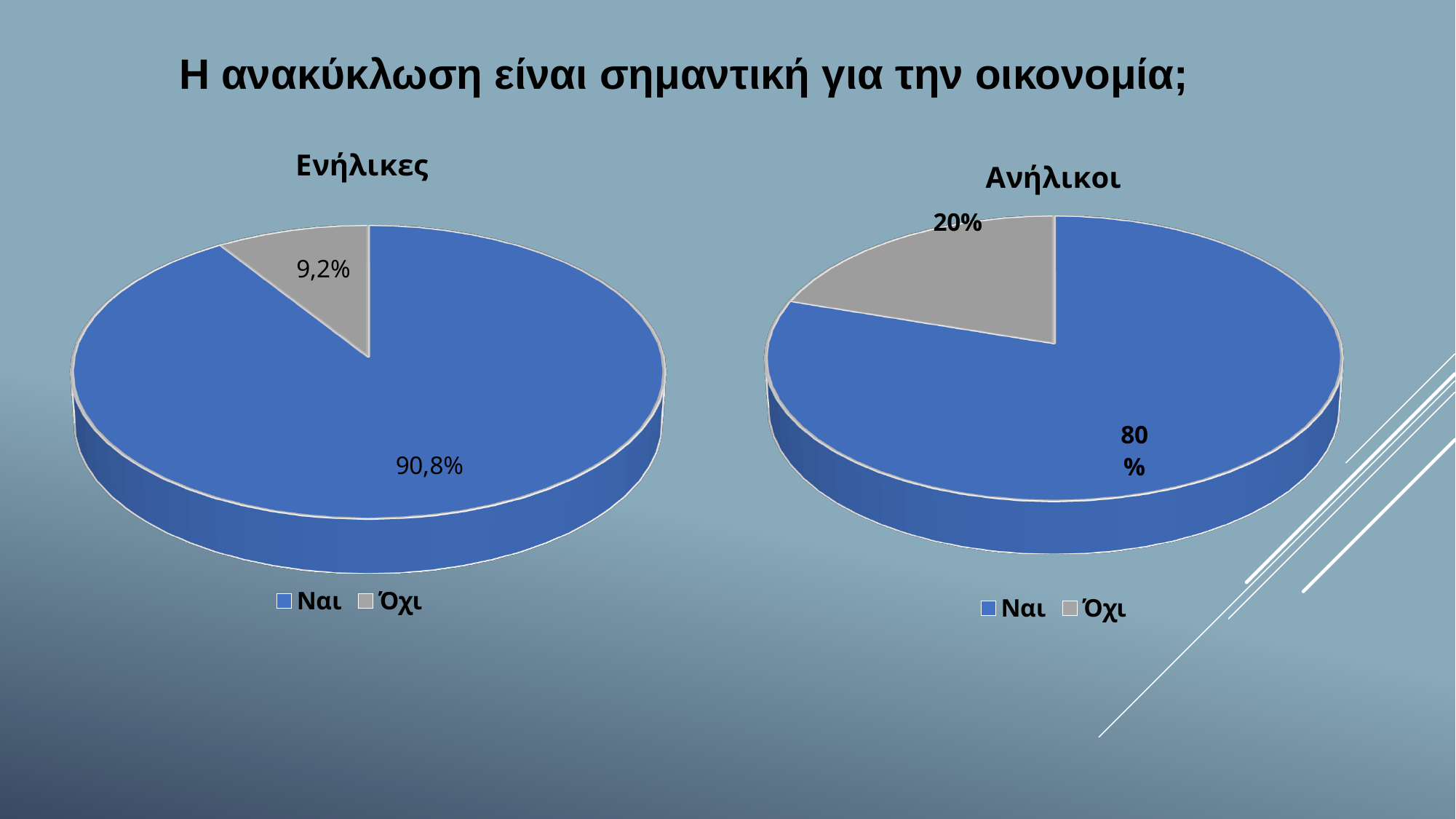
In the Ανήλικοι chart, what is the difference between the Ναι and Όχι shares? 60% What kind of chart is the Ενήλικες chart? Pie chart In the Ενήλικες chart, which slice is the largest? Ναι In the Ανήλικοι chart, what colour is the Όχι slice? Grey Which chart has the larger Όχι share, Ενήλικες or Ανήλικοι? Ανήλικοι In the Ανήλικοι chart, what share of the pie is Όχι? 20% In the Ανήλικοι chart, what share of the pie is Ναι? 80% In the Ανήλικοι chart, which slice is the smallest? Όχι In the Ενήλικες chart, what share of the pie is Ναι? 90,8% How many slices does the Ανήλικοι chart have? 2 What entries does the legend of the Ενήλικες chart list? Ναι, Όχι